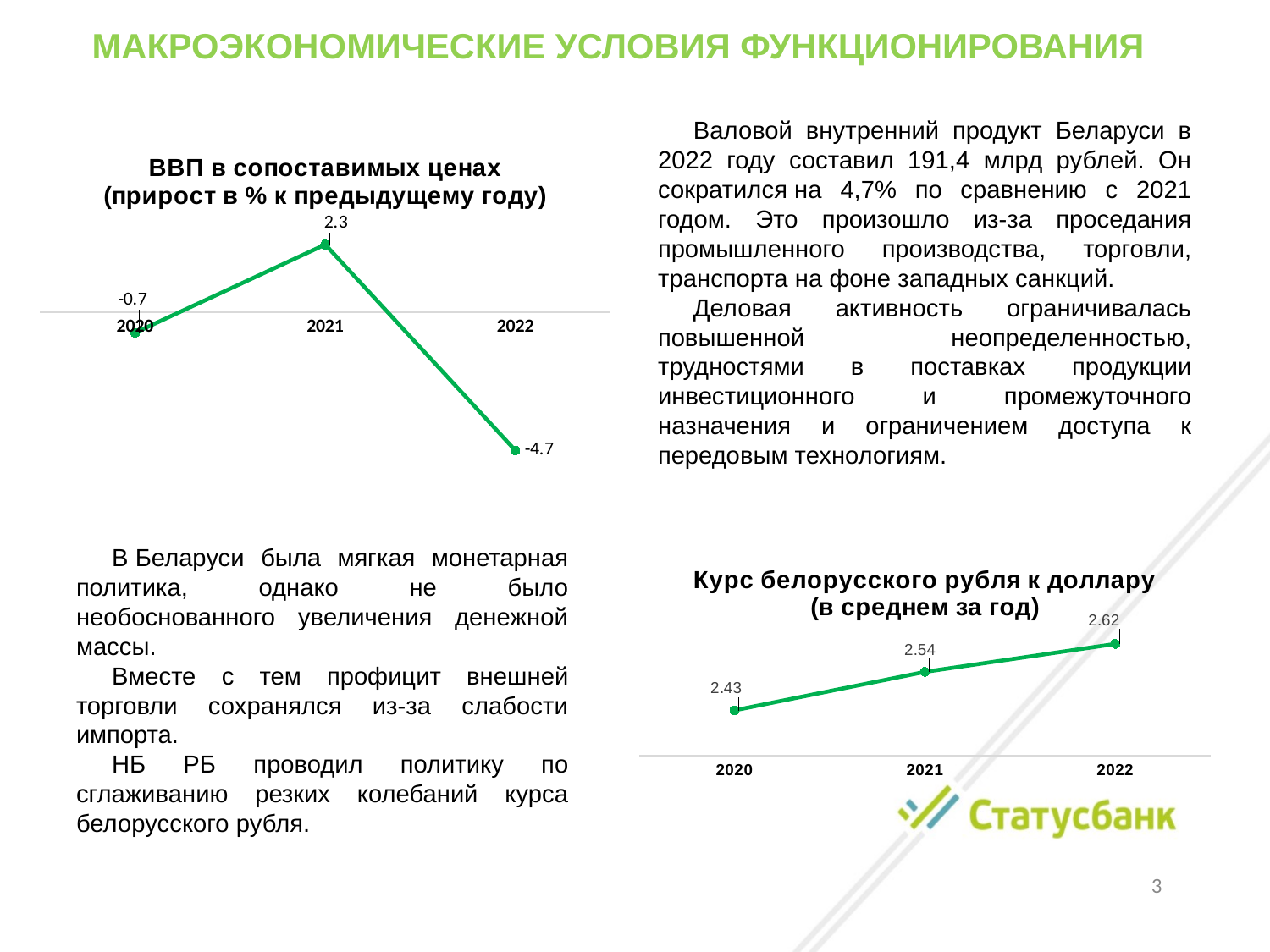
What kind of chart is 'ВВП в сопоставимых ценах (прирост в % к предыдущему году)'? line chart In the chart 'ВВП в сопоставимых ценах (прирост в % к предыдущему году)', which year has the lowest value? 2022 In the chart 'Курс белорусского рубля к доллару (в среднем за год)', do the values rise or fall from 2020 to 2022? rise In the chart 'Курс белорусского рубля к доллару (в среднем за год)', what is the value for 2020? 2.43 In the chart 'ВВП в сопоставимых ценах (прирост в % к предыдущему году)', how many years are plotted? 3 In the chart 'ВВП в сопоставимых ценах (прирост в % к предыдущему году)', which year has the highest value? 2021 In the chart 'ВВП в сопоставимых ценах (прирост в % к предыдущему году)', what is the value for 2022? -4.7 In the chart 'Курс белорусского рубля к доллару (в среднем за год)', which is larger, the value for 2020 or the value for 2021? 2021 In the chart 'Курс белорусского рубля к доллару (в среднем за год)', what is the difference between the 2022 value and the 2021 value? 0.08 In the chart 'ВВП в сопоставимых ценах (прирост в % к предыдущему году)', what is the difference between the 2021 value and the 2020 value? 3 In the chart 'Курс белорусского рубля к доллару (в среднем за год)', what is the value for 2022? 2.62 In the chart 'ВВП в сопоставимых ценах (прирост в % к предыдущему году)', what is the value for 2021? 2.3